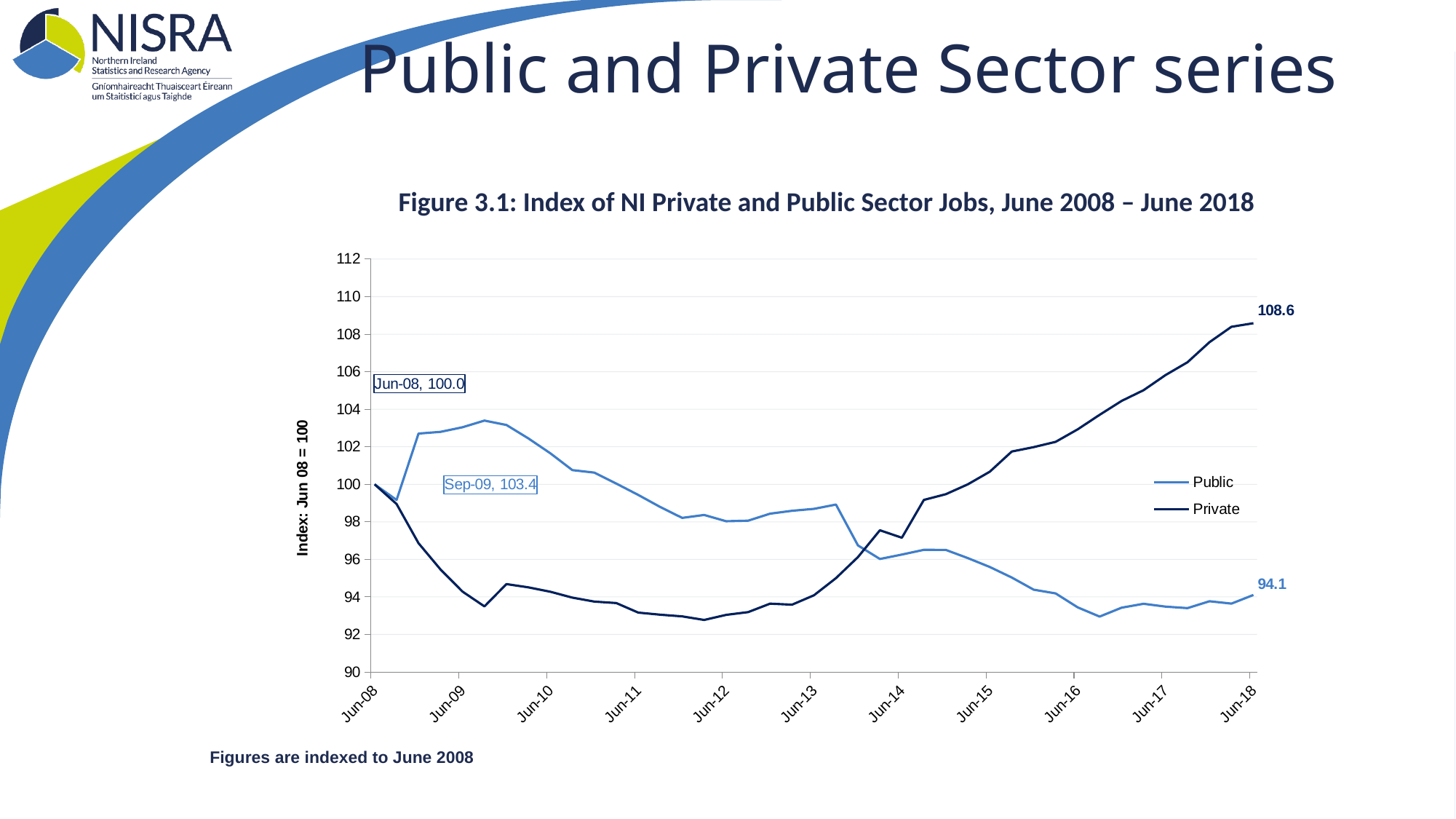
By how much did the Public series fall from its Sep-09 value to its Jun-18 value? 9.3 Is the value of the Private series at Jun-16 greater or less than 100? greater Does the Private series rise or fall between Jun-14 and Jun-18? rises How many series does the legend list? 2 At Jun-18, which series has the higher value, Public or Private? Private What is the label on the vertical axis of the chart? Index: Jun 08 = 100 What is the value of the Public series at Jun-18? 94.1 What kind of chart is shown on the slide? line chart What is the value of the Public series at Sep-09? 103.4 What is the difference between the Private and Public values at Jun-18? 14.5 Is the value of the Public series at Jun-16 greater or less than 96? less What is the value of the Private series at Jun-18? 108.6